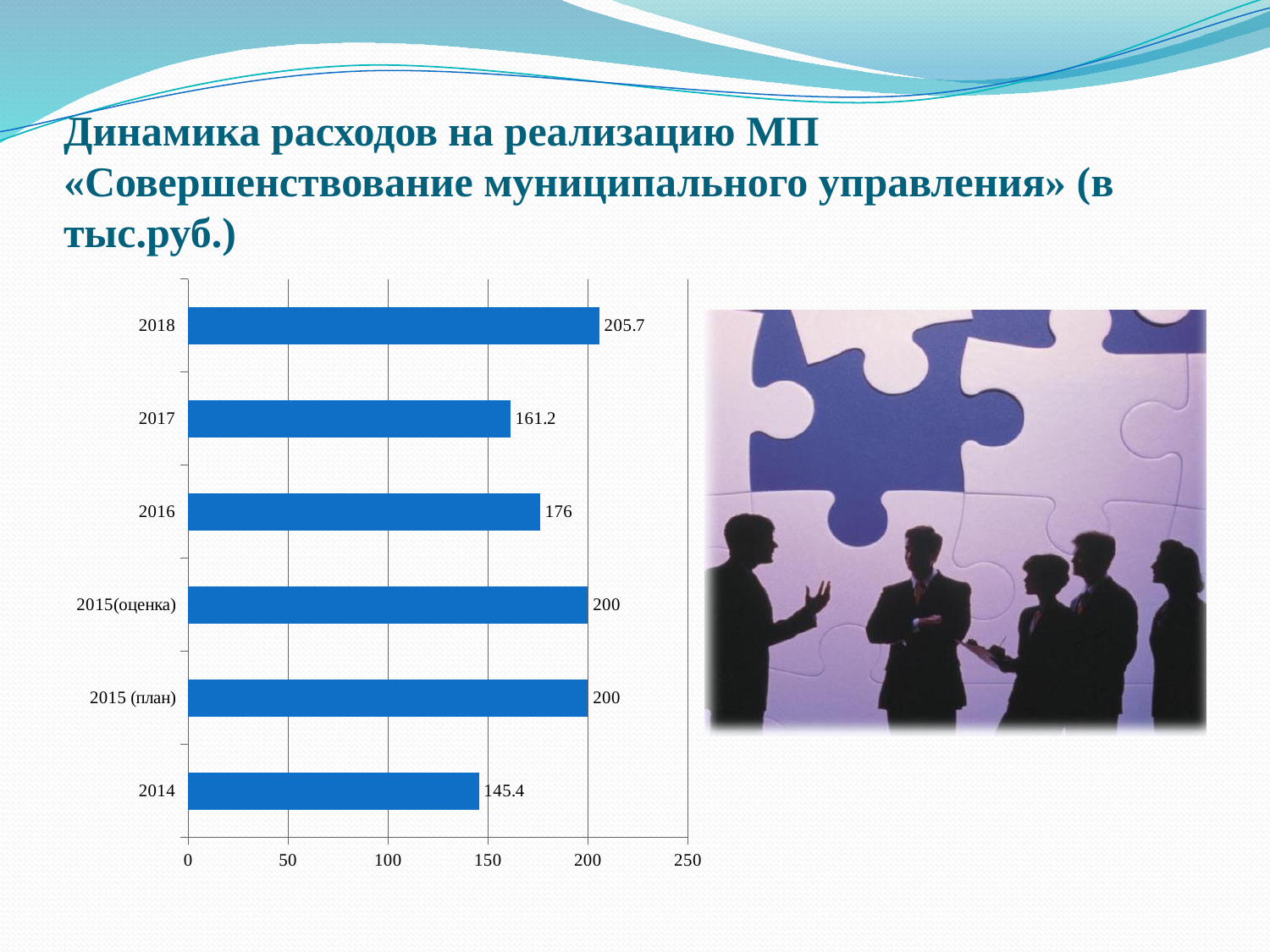
Which category has the lowest value? 2014 What kind of chart is shown on the slide? bar chart What is the value for 2017? 161.2 What is the value for 2016? 176 Which is larger, the value for 2016 or the value for 2017? 2016 What is the maximum value shown on the horizontal axis? 250 Which category has the highest value? 2018 What is the difference between the values for 2018 and 2017? 44.5 What is the value for 2018? 205.7 How many categories are shown on the chart? 6 What is the value for 2014? 145.4 Is the value for 2014 greater or less than 150? less